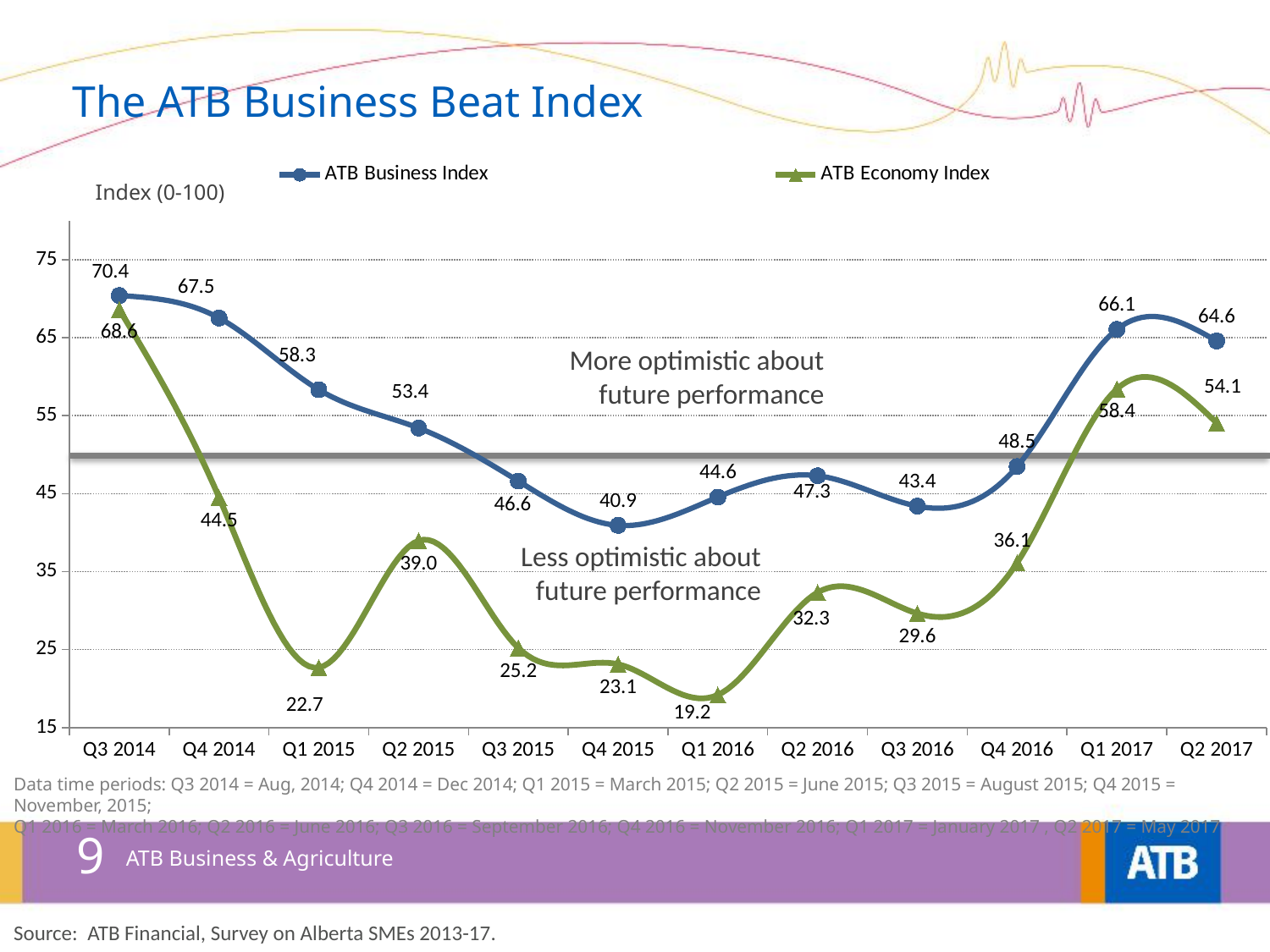
What is the difference between the ATB Business Index and the ATB Economy Index in Q2 2017? 10.5 In which quarter is the ATB Economy Index lowest? Q1 2016 What type of chart is shown on the slide? Line chart What is the value of the ATB Business Index in Q4 2015? 40.9 What is the value of the ATB Business Index in Q3 2014? 70.4 How many series does the legend list? 2 In which quarter is the ATB Business Index highest? Q3 2014 How many quarters are plotted on the x axis? 12 Which is larger in Q1 2015, the ATB Business Index or the ATB Economy Index? ATB Business Index What is the title of the chart on the slide? The ATB Business Beat Index What is the value of the ATB Economy Index in Q1 2016? 19.2 Does the ATB Business Index rise or fall from Q3 2014 to Q4 2015? Fall